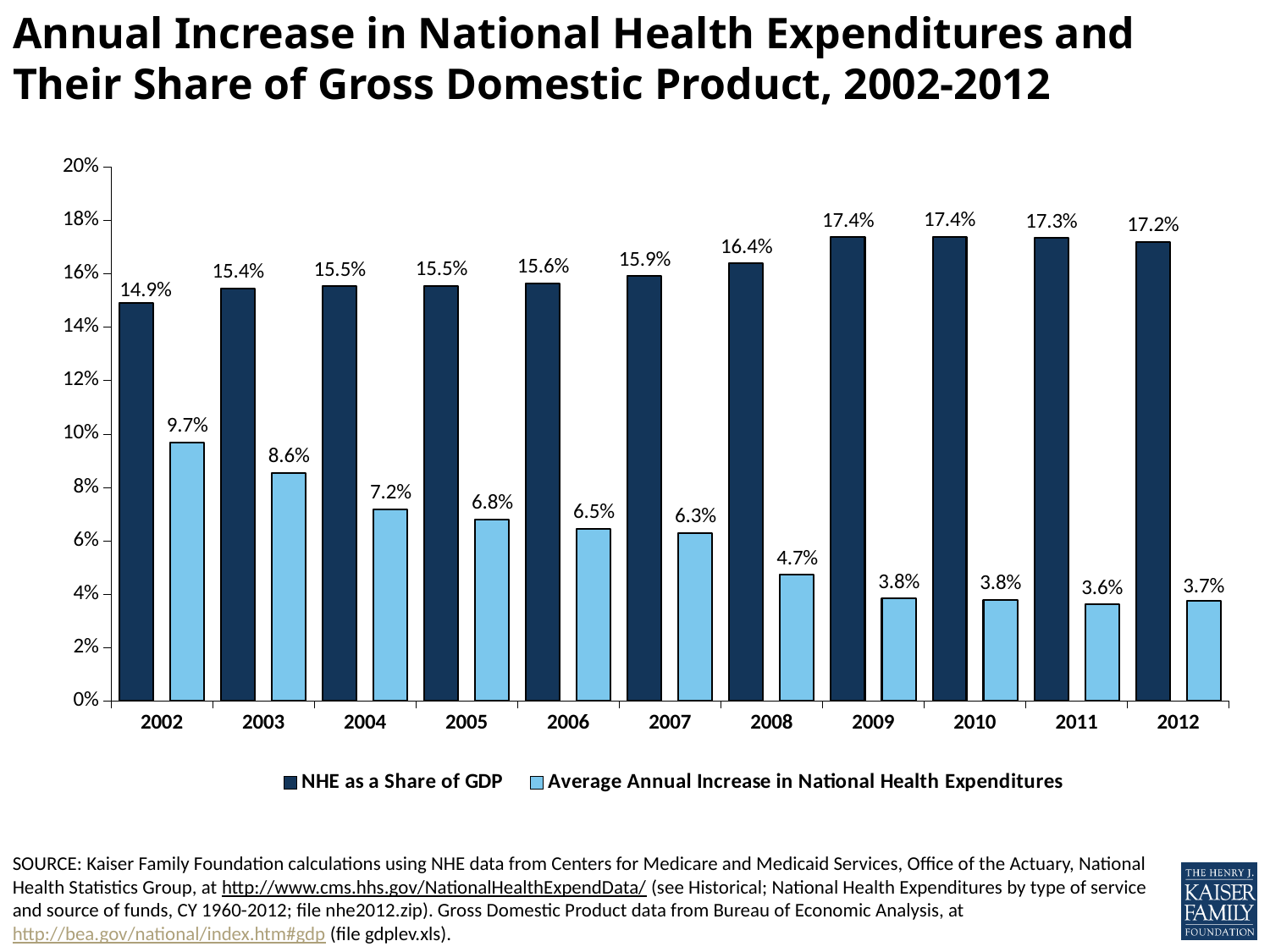
How many years are shown on the x axis? 11 In which year was the Average Annual Increase in National Health Expenditures lowest? 2011 What was NHE as a Share of GDP in 2002? 14.9% What type of chart is shown on the slide? Bar chart In which year was NHE as a Share of GDP lowest? 2002 What was the Average Annual Increase in National Health Expenditures in 2008? 4.7% In which year was the Average Annual Increase in National Health Expenditures highest? 2002 What was NHE as a Share of GDP in 2012? 17.2% Does the Average Annual Increase in National Health Expenditures generally rise or fall from 2002 to 2012? Fall How many series does the legend list? 2 What is the difference between the Average Annual Increase in National Health Expenditures in 2002 and in 2012? 6.0 percentage points Which is larger: the Average Annual Increase in National Health Expenditures in 2003 or in 2007? 2003